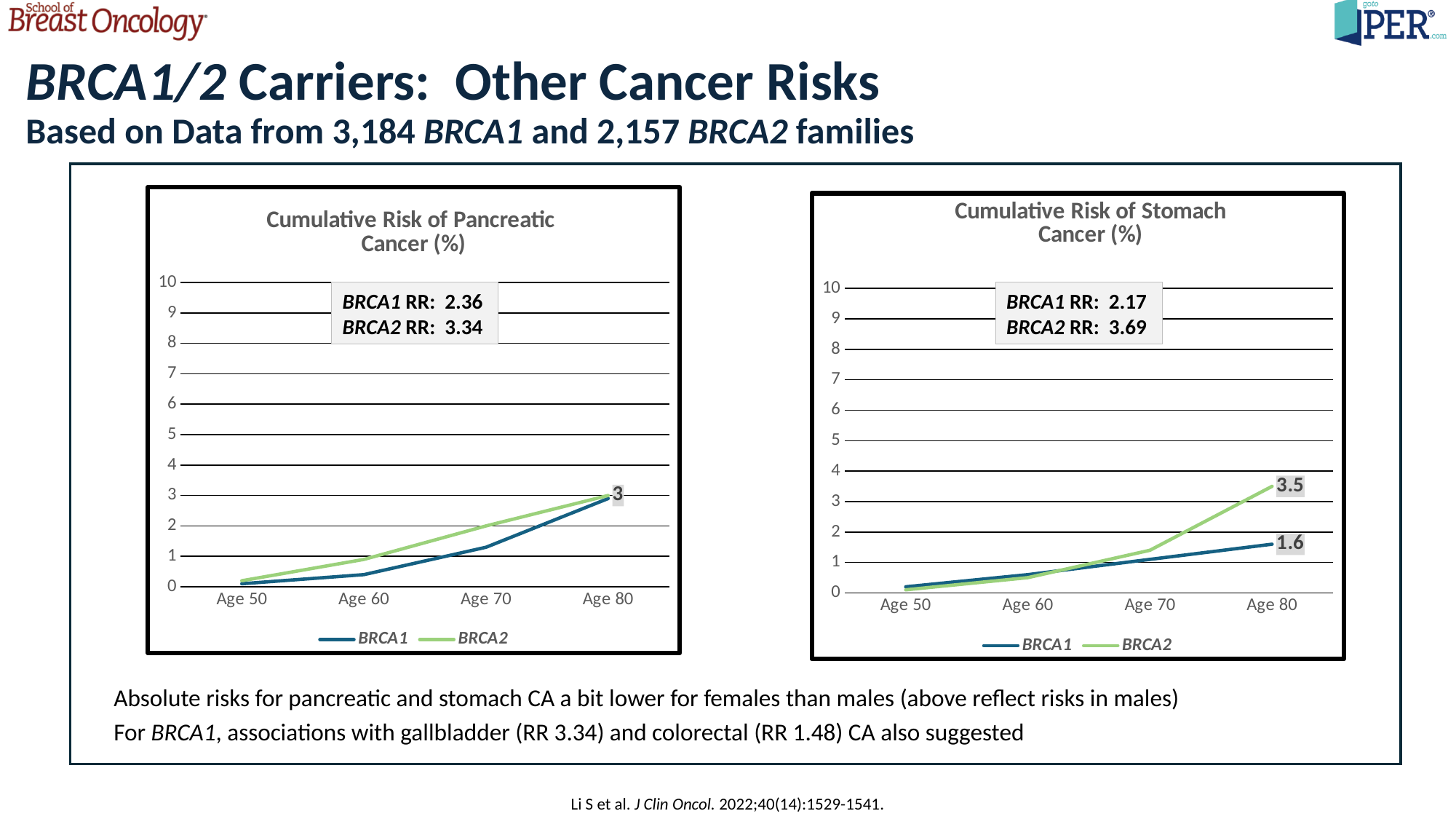
How many age categories are shown on the x axis of the Cumulative Risk of Pancreatic Cancer (%) chart? 4 In the Cumulative Risk of Stomach Cancer (%) chart, what is the value for BRCA1 at Age 80? 1.6 In the Cumulative Risk of Stomach Cancer (%) chart, what is the value for BRCA2 at Age 80? 3.5 In the Cumulative Risk of Pancreatic Cancer (%) chart, what data label is shown at Age 80? 3 How many series does the legend of the Cumulative Risk of Stomach Cancer (%) chart list? 2 What BRCA2 RR is shown in the text box on the Cumulative Risk of Stomach Cancer (%) chart? 3.69 In the Cumulative Risk of Pancreatic Cancer (%) chart, do the values rise or fall from Age 50 to Age 80? rise In the Cumulative Risk of Pancreatic Cancer (%) chart, is the BRCA1 value at Age 60 greater or less than 1? less What kind of chart is the Cumulative Risk of Pancreatic Cancer (%) chart? line chart In the Cumulative Risk of Stomach Cancer (%) chart, which series has the higher value at Age 80, BRCA1 or BRCA2? BRCA2 In the Cumulative Risk of Stomach Cancer (%) chart, what is the difference between the BRCA2 and BRCA1 values at Age 80? 1.9 In the Cumulative Risk of Stomach Cancer (%) chart, is the BRCA2 value at Age 70 greater or less than 2? less